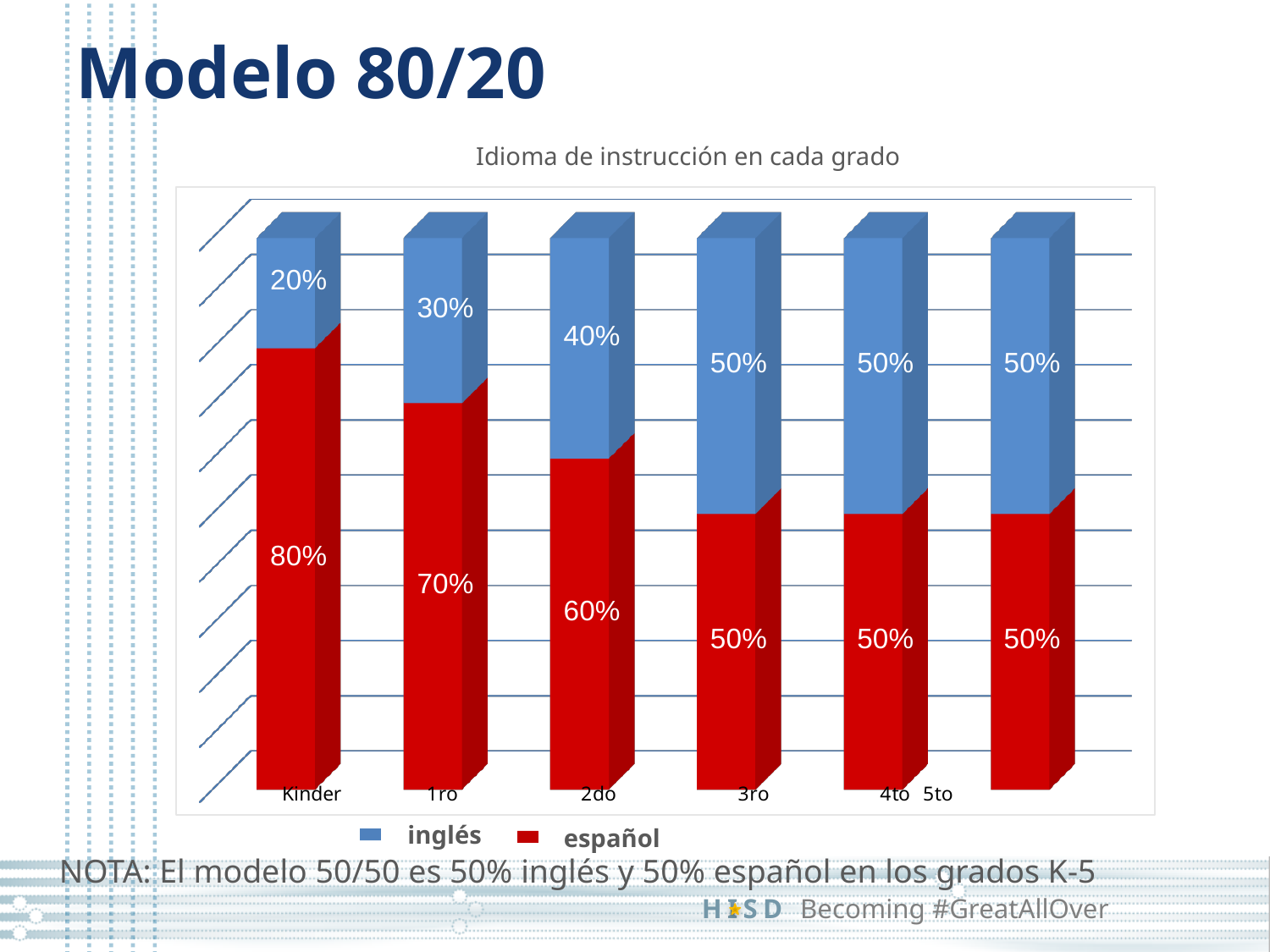
How many series does the legend list? 2 What is the inglés value for 1ro? 30% For 2do, which is larger, the inglés value or the español value? español What is the inglés value for 2do? 40% What is the español value for Kinder? 80% What is the español value for 3ro? 50% How many grades are shown on the x axis? 6 Which grade has the highest español value? Kinder What is the difference between the español and inglés values for 1ro? 40% What kind of chart is shown on the slide? stacked bar chart Does the inglés value rise or fall from Kinder to 3ro? rise Which grade has the lowest inglés value? Kinder